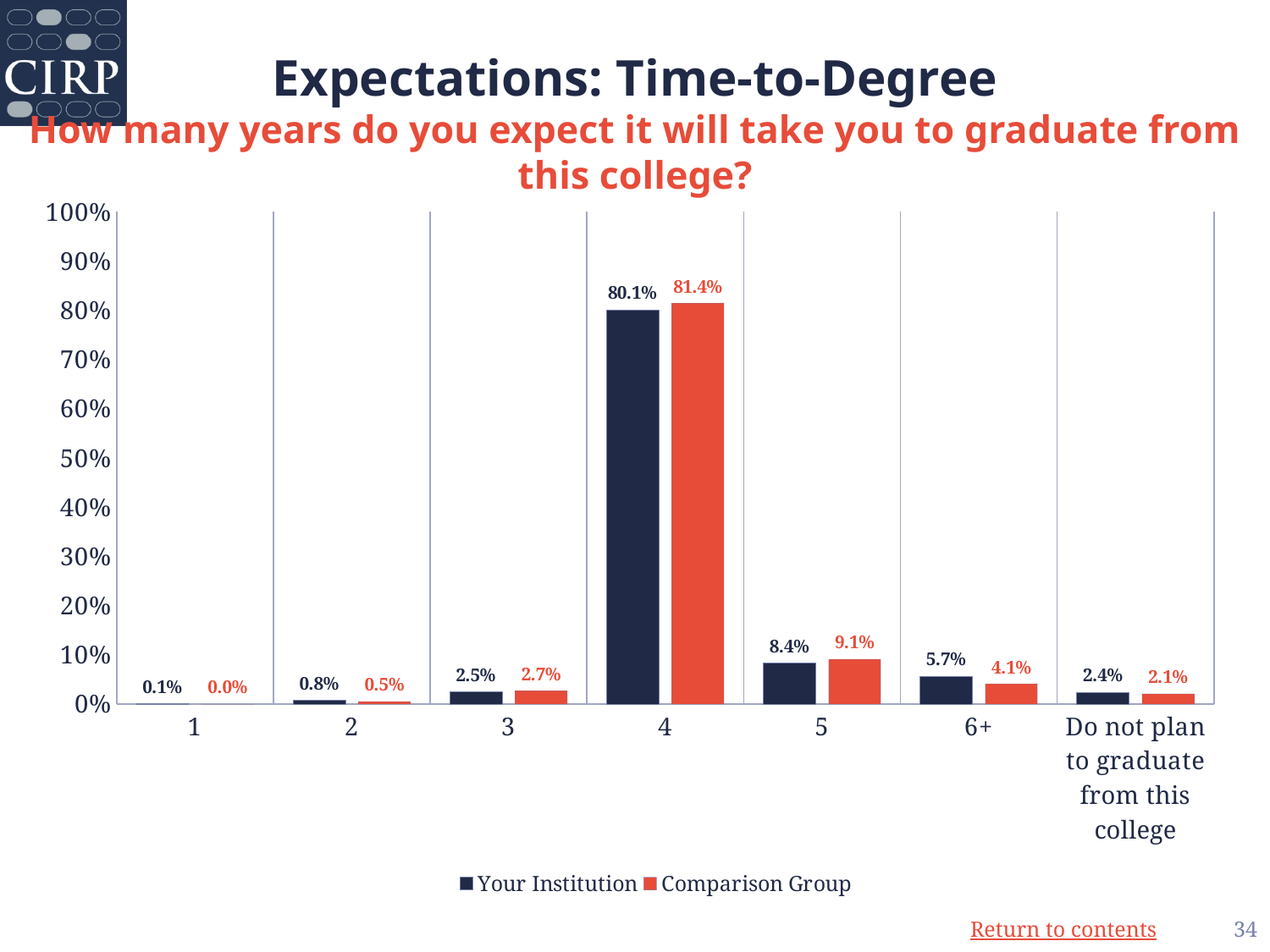
Is the value for Your Institution in the 4 category greater or less than 70%? greater What kind of chart is shown on the slide? bar chart What is the value for Your Institution in the 4 category? 80.1% What is the difference between Comparison Group and Your Institution in the 4 category? 1.3% How many series does the legend list? 2 What is the value for Your Institution in the 6+ category? 5.7% Which category has the lowest value for Your Institution? 1 In the 6+ category, which series has the larger value, Your Institution or Comparison Group? Your Institution How many categories are shown on the x axis? 7 Which category has the highest value for Comparison Group? 4 What is the value for Comparison Group in the 5 category? 9.1% What is the value for Comparison Group in the 'Do not plan to graduate from this college' category? 2.1%